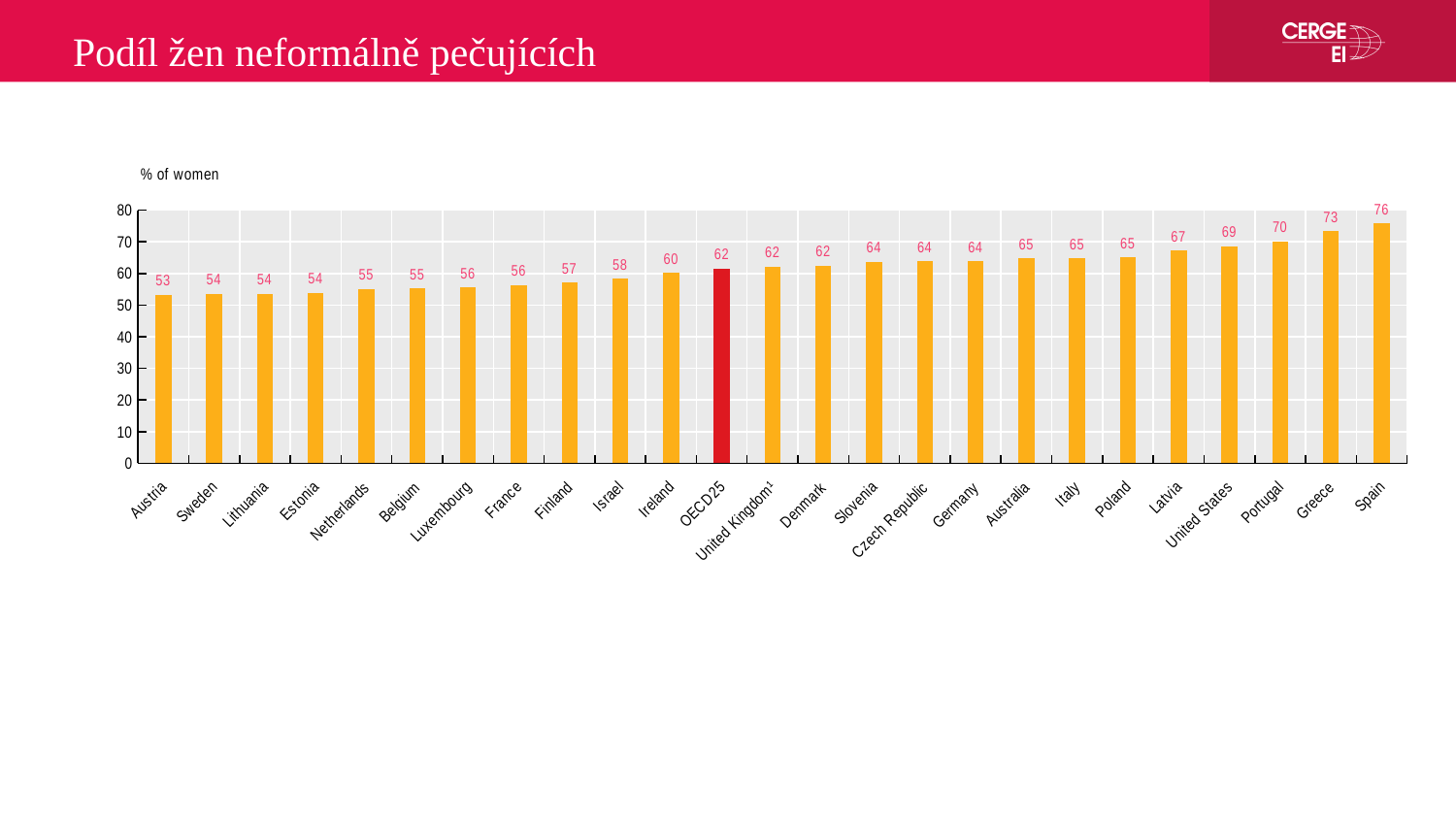
What is the value for OECD25? 62 Which has a larger value, Greece or Portugal? Greece How many bars are shown in the chart? 25 What kind of chart is shown on the slide? bar chart Do the values rise or fall from left to right along the x axis? rise Which category has the highest value? Spain What is the difference between the values for Spain and Austria? 23 What is the value for the Czech Republic? 64 Which bar is coloured red instead of orange? OECD25 What is the value for Spain? 76 Which category has the lowest value? Austria Is the value for Latvia greater or less than 60? greater